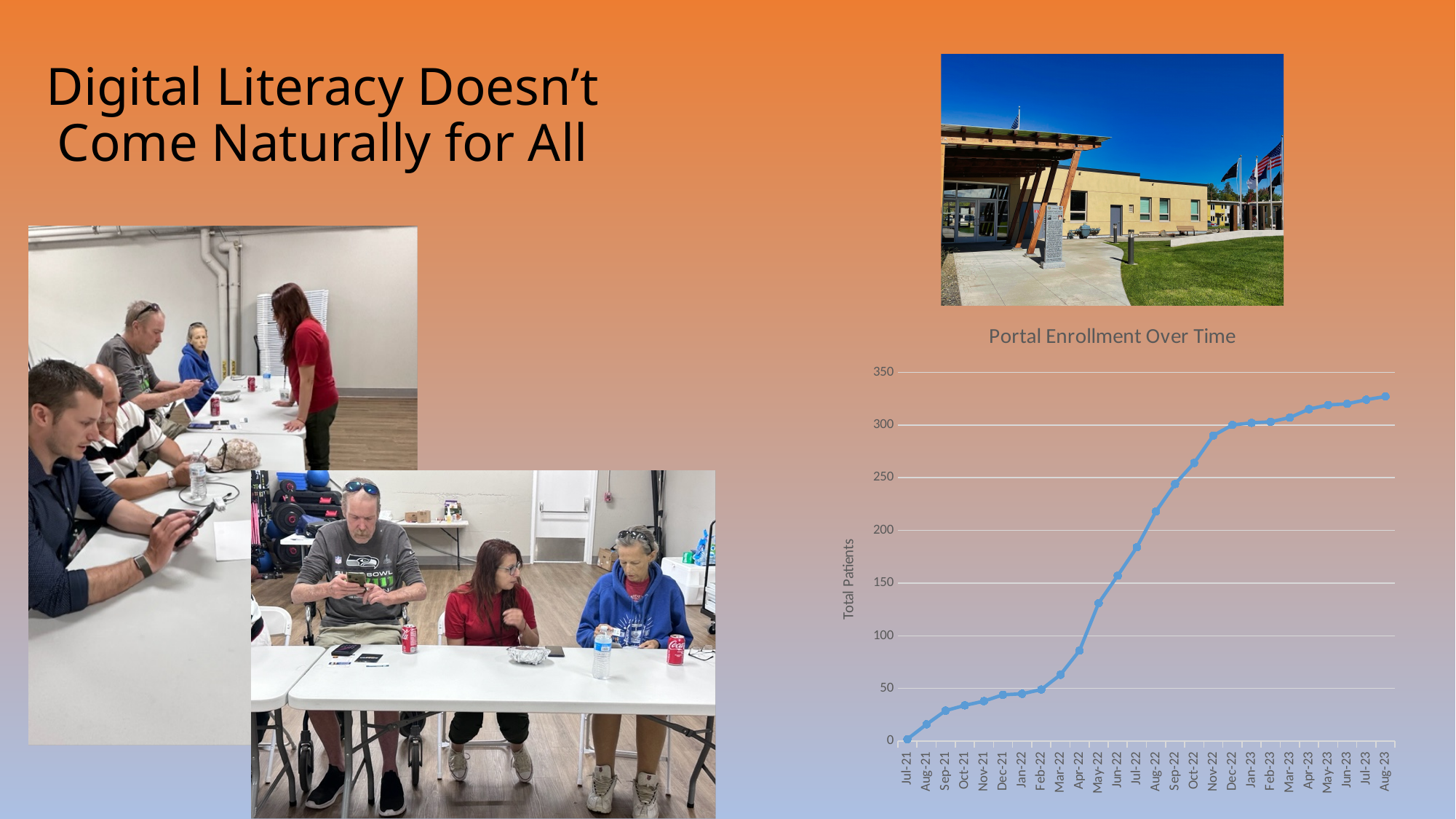
Is the value for Apr-22 on the Portal Enrollment Over Time chart greater or less than 100? less Do the values on the Portal Enrollment Over Time chart rise or fall from Jul-21 to Aug-23? rise What type of chart is used to show Portal Enrollment Over Time? line chart What is the title of the chart on the slide? Portal Enrollment Over Time Is the value for Aug-23 on the Portal Enrollment Over Time chart greater or less than 300? greater How many monthly data points are plotted on the Portal Enrollment Over Time chart? 26 Which month has the highest value on the Portal Enrollment Over Time chart? Aug-23 What is the label on the vertical axis of the Portal Enrollment Over Time chart? Total Patients Which month has the lowest value on the Portal Enrollment Over Time chart? Jul-21 On the Portal Enrollment Over Time chart, which is larger, the value for Jan-22 or the value for Jul-22? Jul-22 Is the value for Jul-22 on the Portal Enrollment Over Time chart greater or less than 150? greater